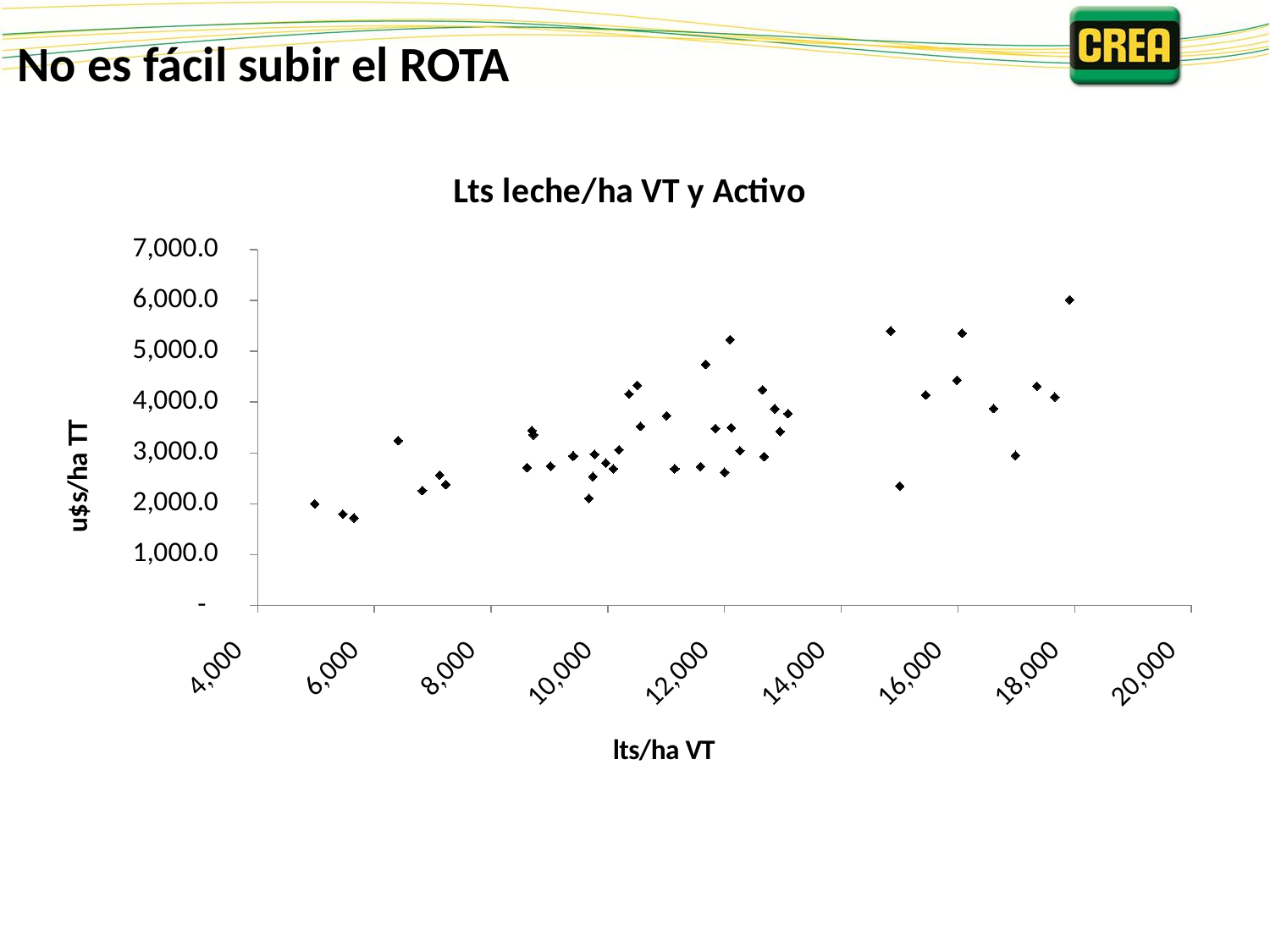
Is the y value of the lowest plotted point greater or less than 2,000.0? less What is the label on the vertical axis of the chart? u$s/ha TT Is the y value of the highest plotted point greater or less than 5,000.0? greater Is the x value of the leftmost plotted point greater or less than 6,000? less Do the plotted values generally rise or fall as lts/ha VT increases along the x axis? Rise What kind of chart is shown on the slide? Scatter chart What is the title of the chart? Lts leche/ha VT y Activo